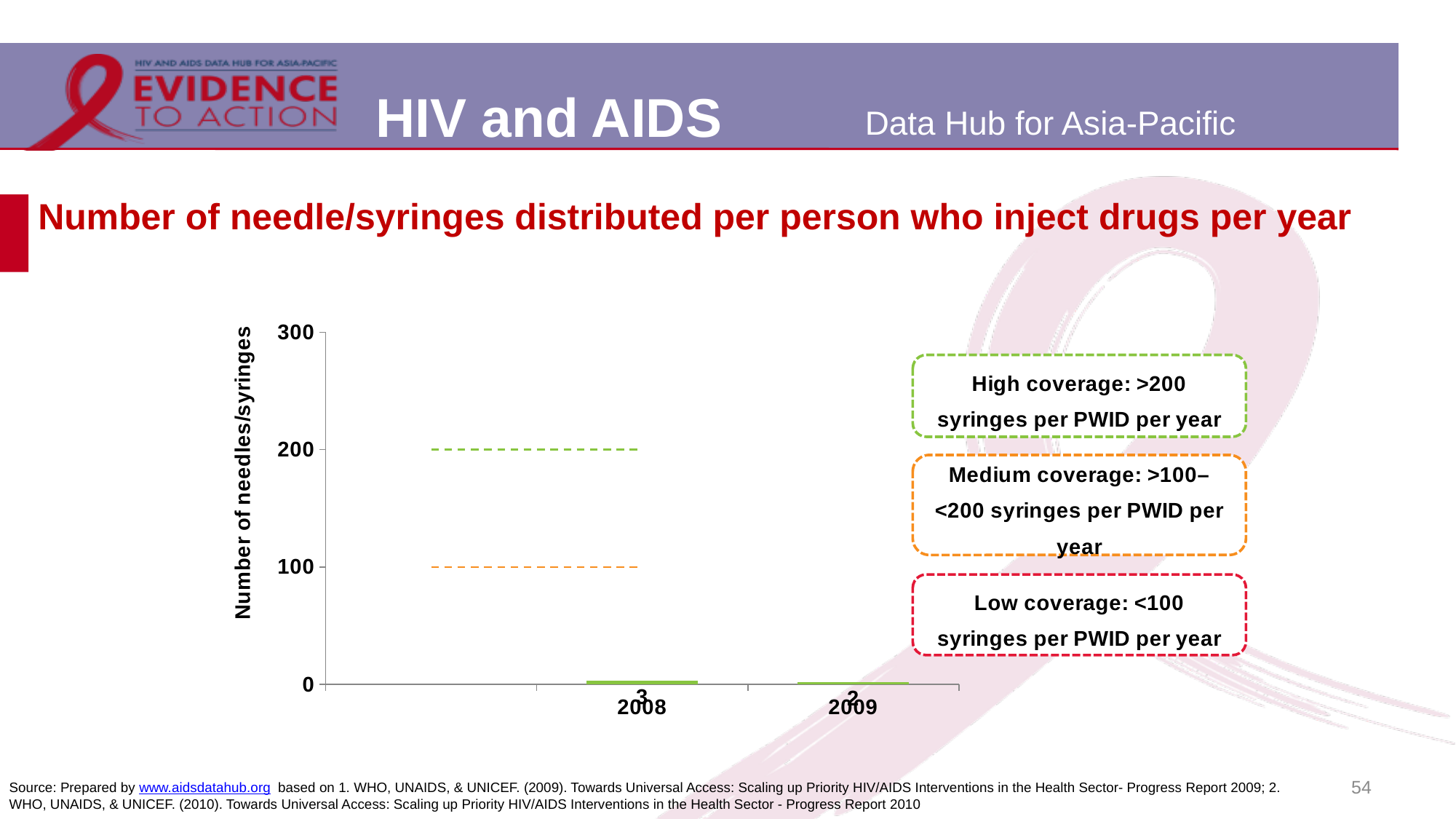
Which year has the higher value, 2008 or 2009? 2008 What is the number of needles/syringes distributed per person who injects drugs in 2009? 2 What is the number of needles/syringes distributed per person who injects drugs in 2008? 3 What is the label of the y axis of the chart? Number of needles/syringes Which year has the lowest number of needles/syringes distributed per person? 2009 What is the highest value shown on the y axis of the chart? 300 Do the values rise or fall from 2008 to 2009? fall Is the value for 2008 greater or less than 100? less What is the difference between the 2008 and 2009 values? 1 What kind of chart is shown on the slide? bar chart How many years are shown on the x axis of the chart? 2